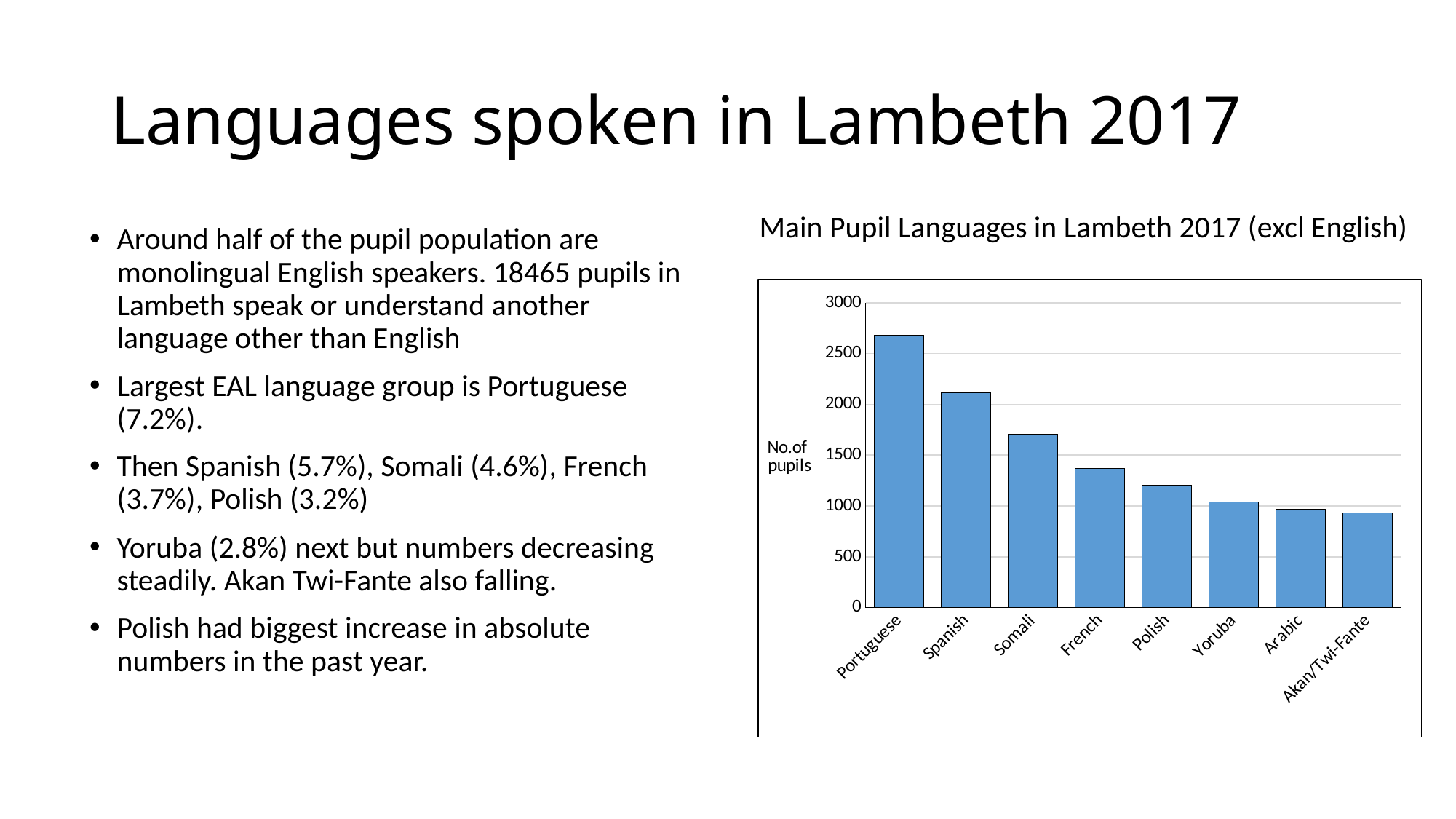
Is the value for Spanish greater or less than 2000? greater What is the label on the vertical axis of the chart? No.of pupils Is the value for Portuguese greater or less than 2500? greater How many languages are plotted in the chart? 8 Is the value for Somali greater or less than 1500? greater Which language has the highest number of pupils in the chart? Portuguese What kind of chart is shown on the slide? bar chart Which has more pupils, Spanish or Somali? Spanish What is the title of the chart? Main Pupil Languages in Lambeth 2017 (excl English) Do the values rise or fall moving from left to right along the x axis? fall